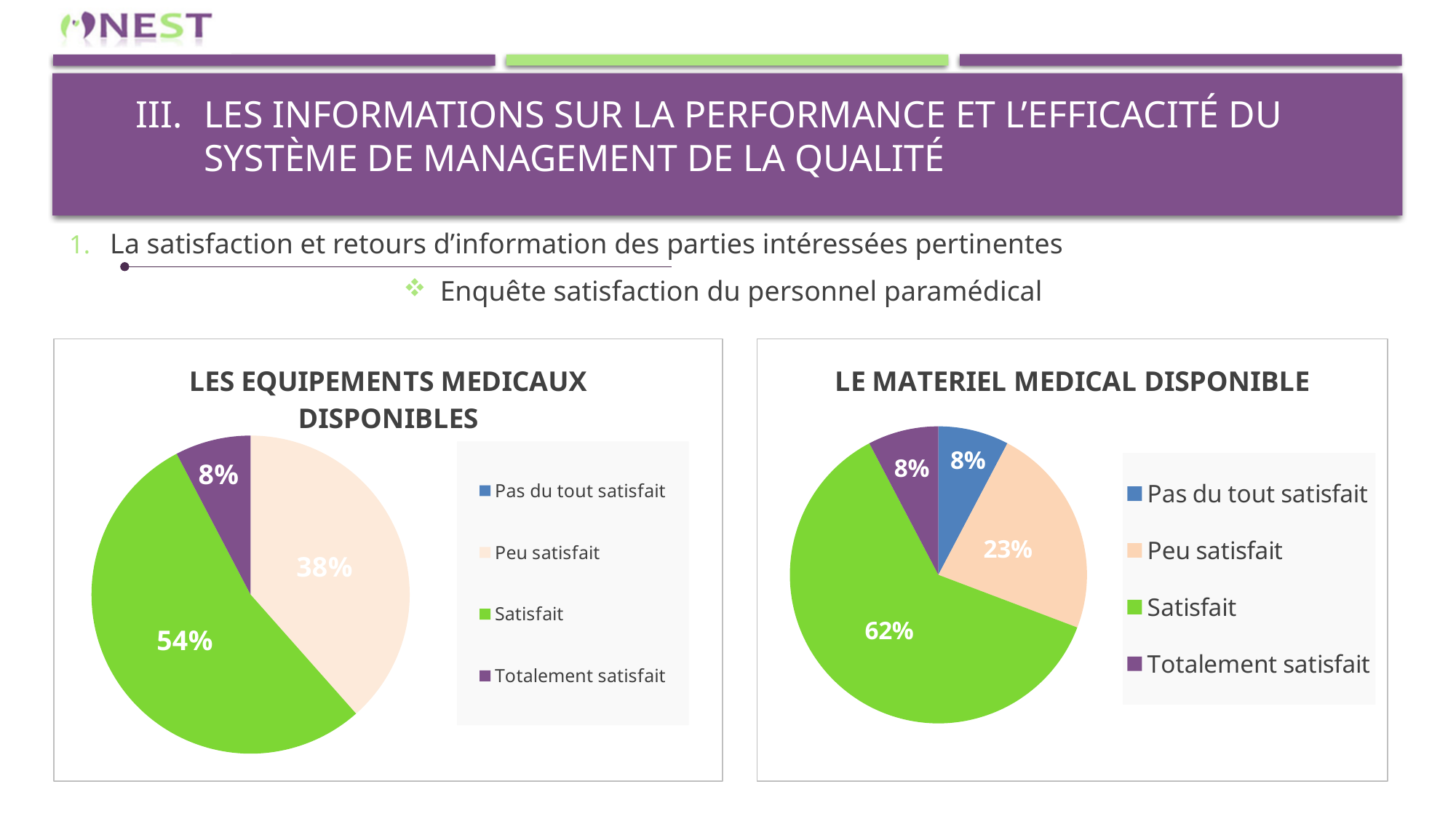
In the chart titled "LES EQUIPEMENTS MEDICAUX DISPONIBLES", what share is labelled for Satisfait? 54% In the chart titled "LES EQUIPEMENTS MEDICAUX DISPONIBLES", what share is labelled for Peu satisfait? 38% In the chart titled "LE MATERIEL MEDICAL DISPONIBLE", which category has the largest slice? Satisfait In the chart titled "LE MATERIEL MEDICAL DISPONIBLE", what is the difference between the Satisfait and Peu satisfait shares? 39% In the chart titled "LES EQUIPEMENTS MEDICAUX DISPONIBLES", which category has the largest slice? Satisfait How many entries does the legend of the chart titled "LE MATERIEL MEDICAL DISPONIBLE" list? 4 In the chart titled "LES EQUIPEMENTS MEDICAUX DISPONIBLES", what is the difference between the Satisfait and Peu satisfait shares? 16% In the chart titled "LE MATERIEL MEDICAL DISPONIBLE", what share is labelled for Satisfait? 62% In the chart titled "LE MATERIEL MEDICAL DISPONIBLE", what share is labelled for Pas du tout satisfait? 8% In the chart titled "LE MATERIEL MEDICAL DISPONIBLE", what share is labelled for Peu satisfait? 23% What type of chart is the chart titled "LES EQUIPEMENTS MEDICAUX DISPONIBLES"? Pie chart In the chart titled "LE MATERIEL MEDICAL DISPONIBLE", how many slices does the pie have? 4